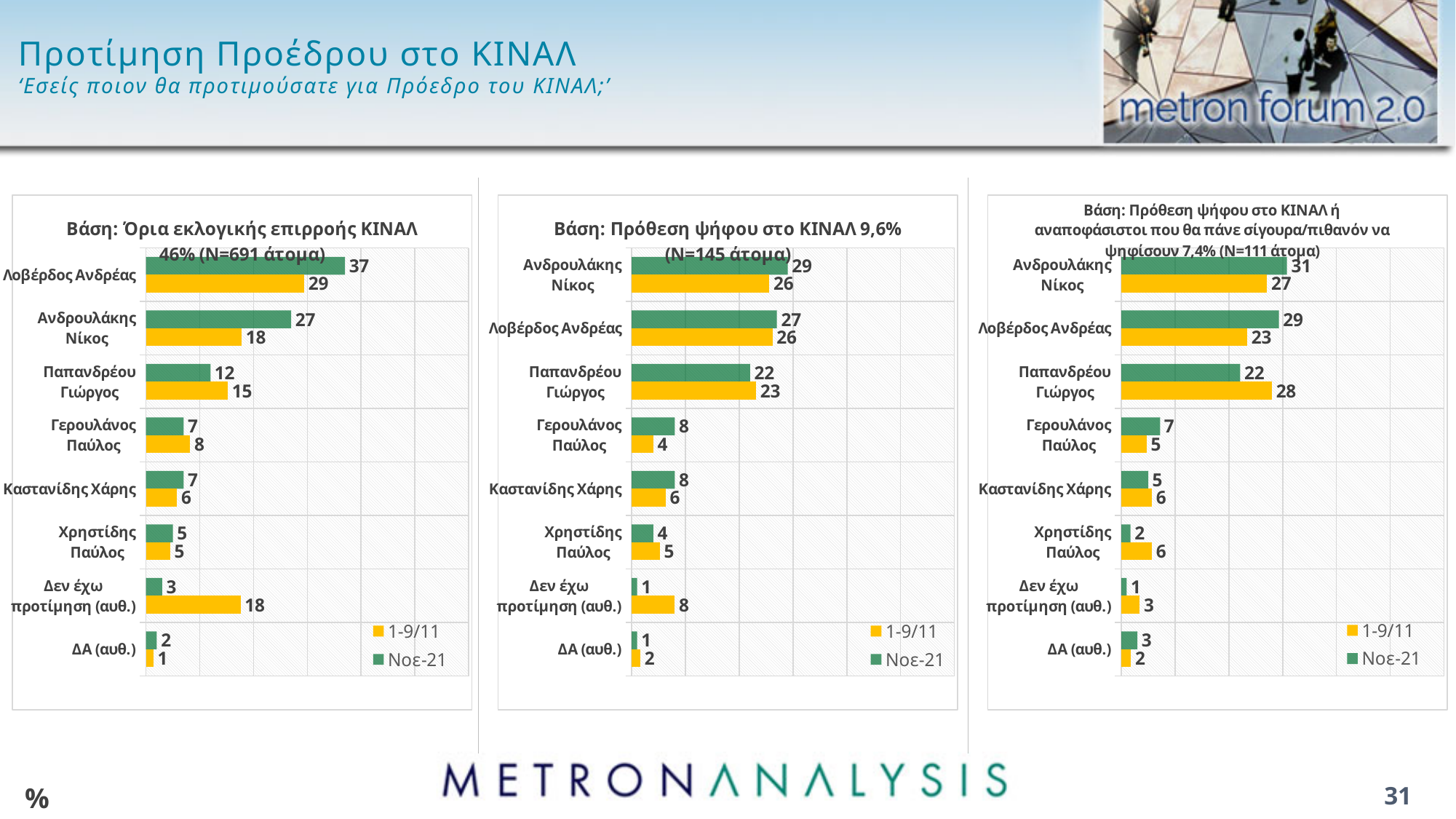
In the right chart (Βάση: Πρόθεση ψήφου στο ΚΙΝΑΛ ή αναποφάσιστοι), which category has the lowest Νοε-21 value? Δεν έχω προτίμηση (αυθ.) In the right chart (Βάση: Πρόθεση ψήφου στο ΚΙΝΑΛ ή αναποφάσιστοι), what is the 1-9/11 value for Παπανδρέου Γιώργος? 28 In the left chart (Βάση: Όρια εκλογικής επιρροής ΚΙΝΑΛ), what is the Νοε-21 value for Λοβέρδος Ανδρέας? 37 What type of chart is the right chart (Βάση: Πρόθεση ψήφου στο ΚΙΝΑΛ ή αναποφάσιστοι)? Bar chart In the left chart (Βάση: Όρια εκλογικής επιρροής ΚΙΝΑΛ), what is the difference between the Νοε-21 and 1-9/11 values for Ανδρουλάκης Νίκος? 9 How many categories are shown in the left chart (Βάση: Όρια εκλογικής επιρροής ΚΙΝΑΛ)? 8 In the middle chart (Βάση: Πρόθεση ψήφου στο ΚΙΝΑΛ 9,6%), what is the 1-9/11 value for Παπανδρέου Γιώργος? 23 In the right chart (Βάση: Πρόθεση ψήφου στο ΚΙΝΑΛ ή αναποφάσιστοι), what is the difference between the Νοε-21 and 1-9/11 values for Λοβέρδος Ανδρέας? 6 In the middle chart (Βάση: Πρόθεση ψήφου στο ΚΙΝΑΛ 9,6%), which candidate has the highest Νοε-21 value? Ανδρουλάκης Νίκος How many series does the legend of the middle chart list? 2 In the middle chart (Βάση: Πρόθεση ψήφου στο ΚΙΝΑΛ 9,6%), which is larger for Γερουλάνος Παύλος: the Νοε-21 value or the 1-9/11 value? Νοε-21 In the left chart (Βάση: Όρια εκλογικής επιρροής ΚΙΝΑΛ), what is the 1-9/11 value for Δεν έχω προτίμηση (αυθ.)? 18